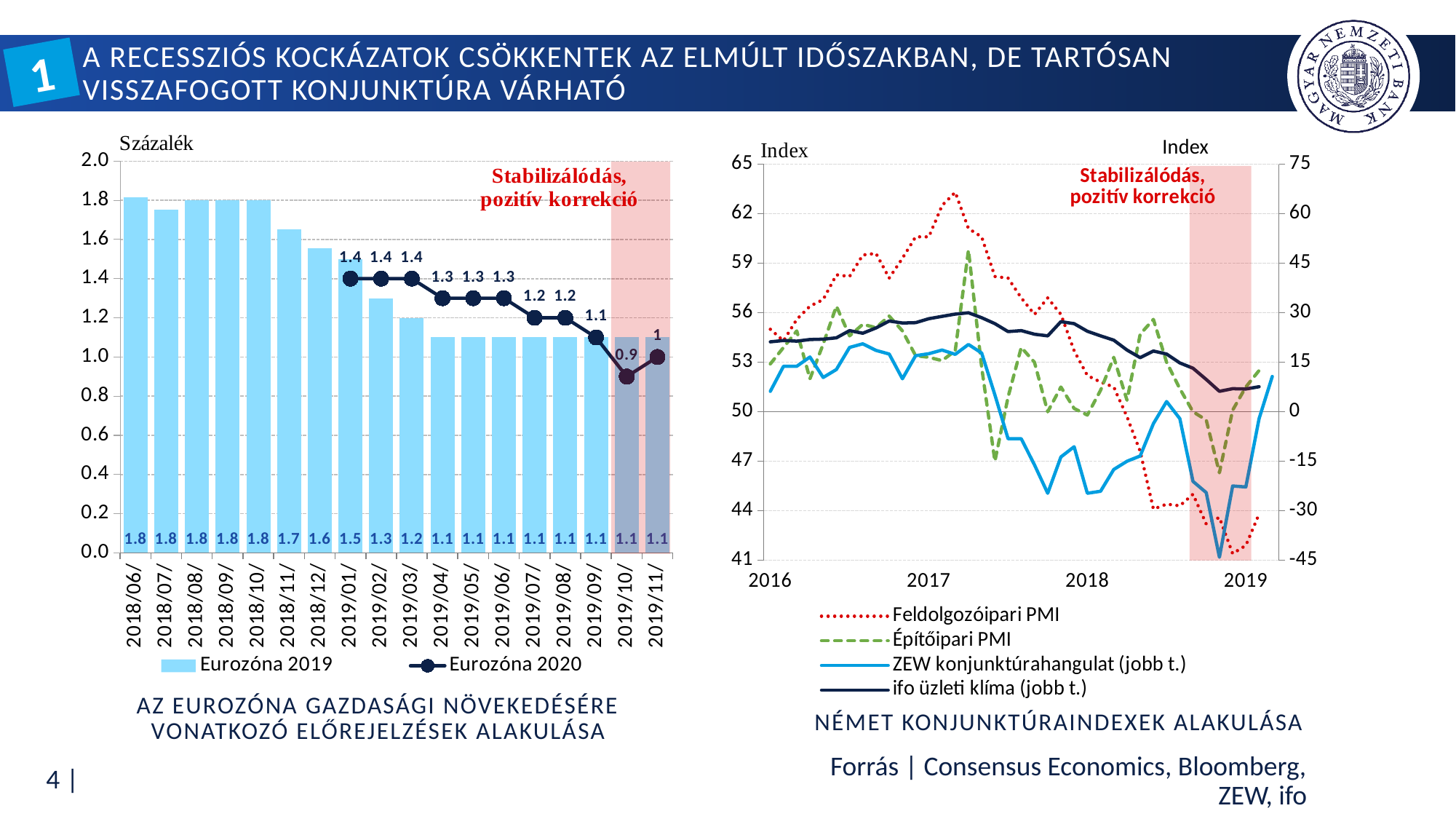
On the left chart, how many months are shown on the x axis? 18 On the left chart, what is the Eurozóna 2019 value for 2018/06? 1.8 How many series does the legend of the right chart list? 4 On the left chart, which is larger for 2019/01: the Eurozóna 2019 value or the Eurozóna 2020 value? Eurozóna 2019 On the left chart, do the Eurozóna 2019 values rise or fall from 2018/06 to 2019/11? fall On the left chart, what is the Eurozóna 2020 value for 2019/11? 1 On the left chart, what is the Eurozóna 2020 value for 2019/10? 0.9 On the left chart, what is the Eurozóna 2019 value for 2018/12? 1.6 What kind of chart is the right chart? line chart On the left chart, which month has the lowest Eurozóna 2020 value? 2019/10 On the left chart, what is the difference between the Eurozóna 2019 value for 2018/06 and for 2019/11? 0.7